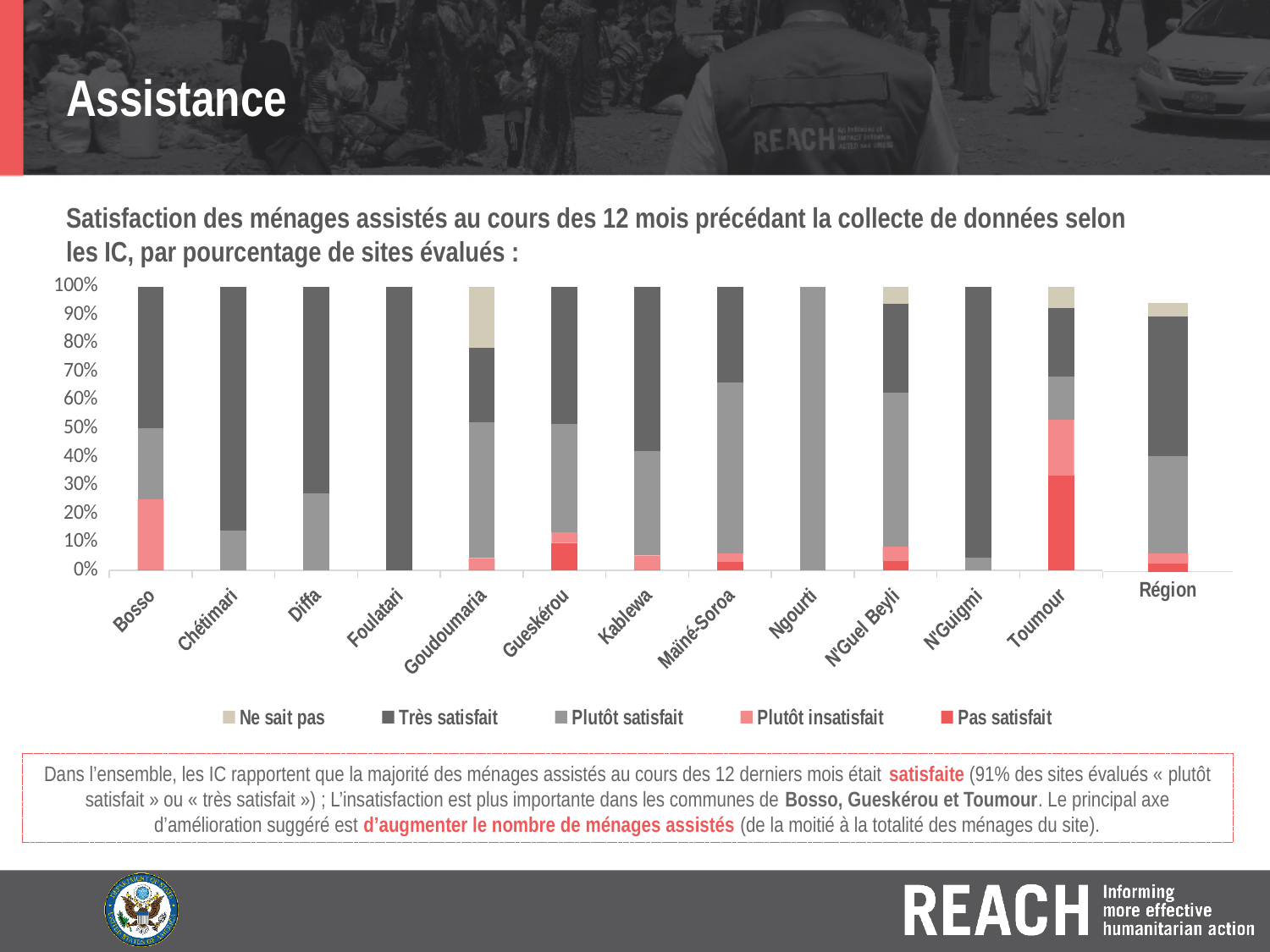
Is the 'Plutôt insatisfait' share for Bosso greater or less than 20%? greater What kind of chart is shown on the slide? Stacked bar chart Which category has the largest 'Pas satisfait' segment? Toumour Which category has the largest 'Ne sait pas' segment? Goudoumaria Is the 'Très satisfait' share for Foulatari greater or less than 90%? greater How many series does the chart legend list? 5 Which legend entry is shown in red? Pas satisfait Which has a larger 'Pas satisfait' share, Toumour or Gueskérou? Toumour Is the 'Plutôt satisfait' share for Chétimari greater or less than 20%? less Which has a larger 'Très satisfait' share, Foulatari or Bosso? Foulatari How many categories are shown along the x axis of the chart? 13